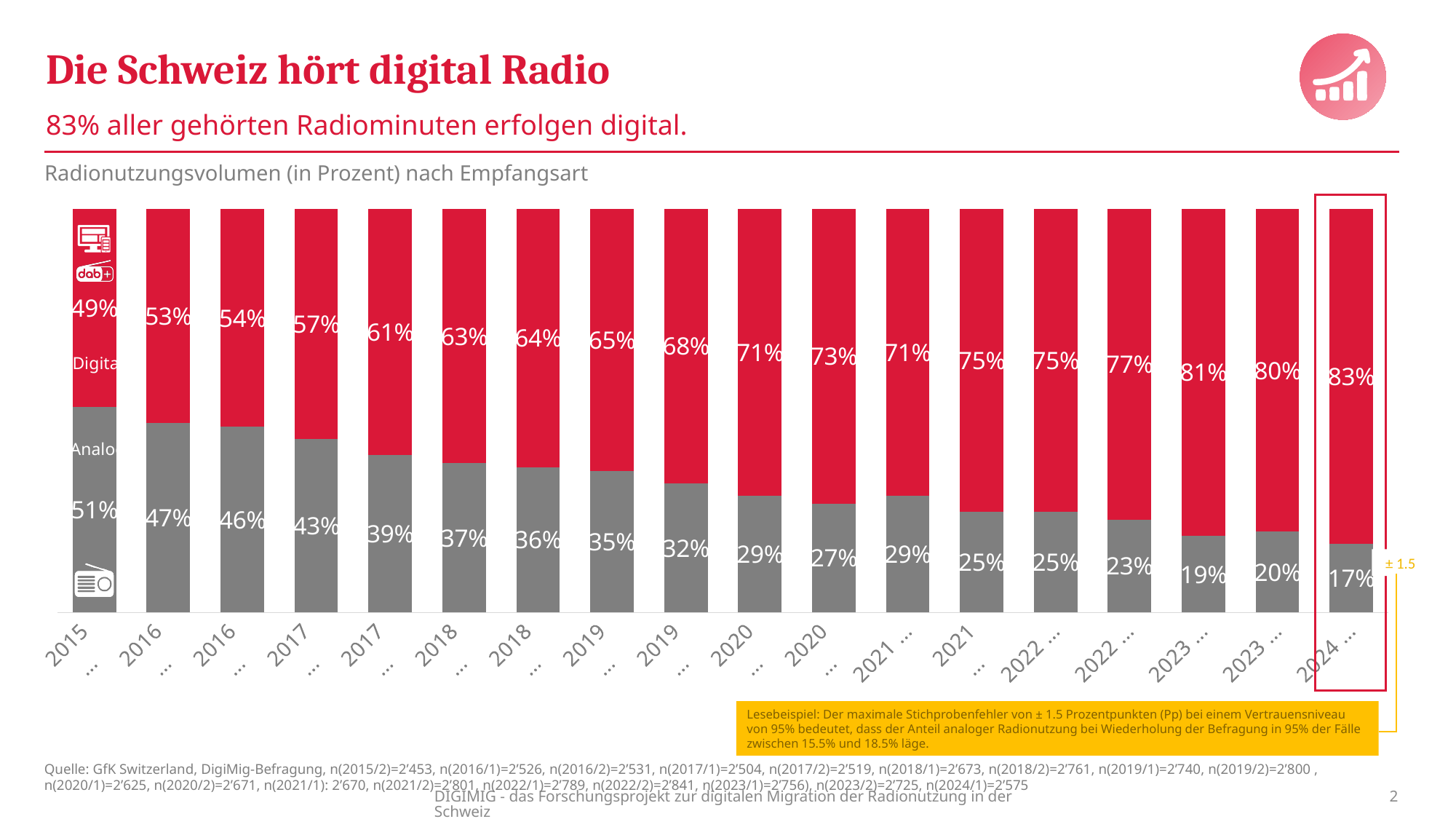
Which bar has the highest Digital share? 2024 (83%) How many series does the chart show? 2 In the first bar (2015), which share is larger, Digital or Analog? Analog Does the Digital share rise or fall from 2015 to 2024? Rises What kind of chart is shown on the slide? Stacked bar chart What is the Analog share in the first bar (2015)? 51% In the 2024 bar, how many percentage points higher is the Digital share than the Analog share? 66 percentage points What is the Digital share in the last bar (2024)? 83% What is the chart's subtitle above the bars? Radionutzungsvolumen (in Prozent) nach Empfangsart How many bars are shown in the chart? 18 Which bar has the lowest Analog share? 2024 (17%) What is the Digital share in the first bar (2015)? 49%